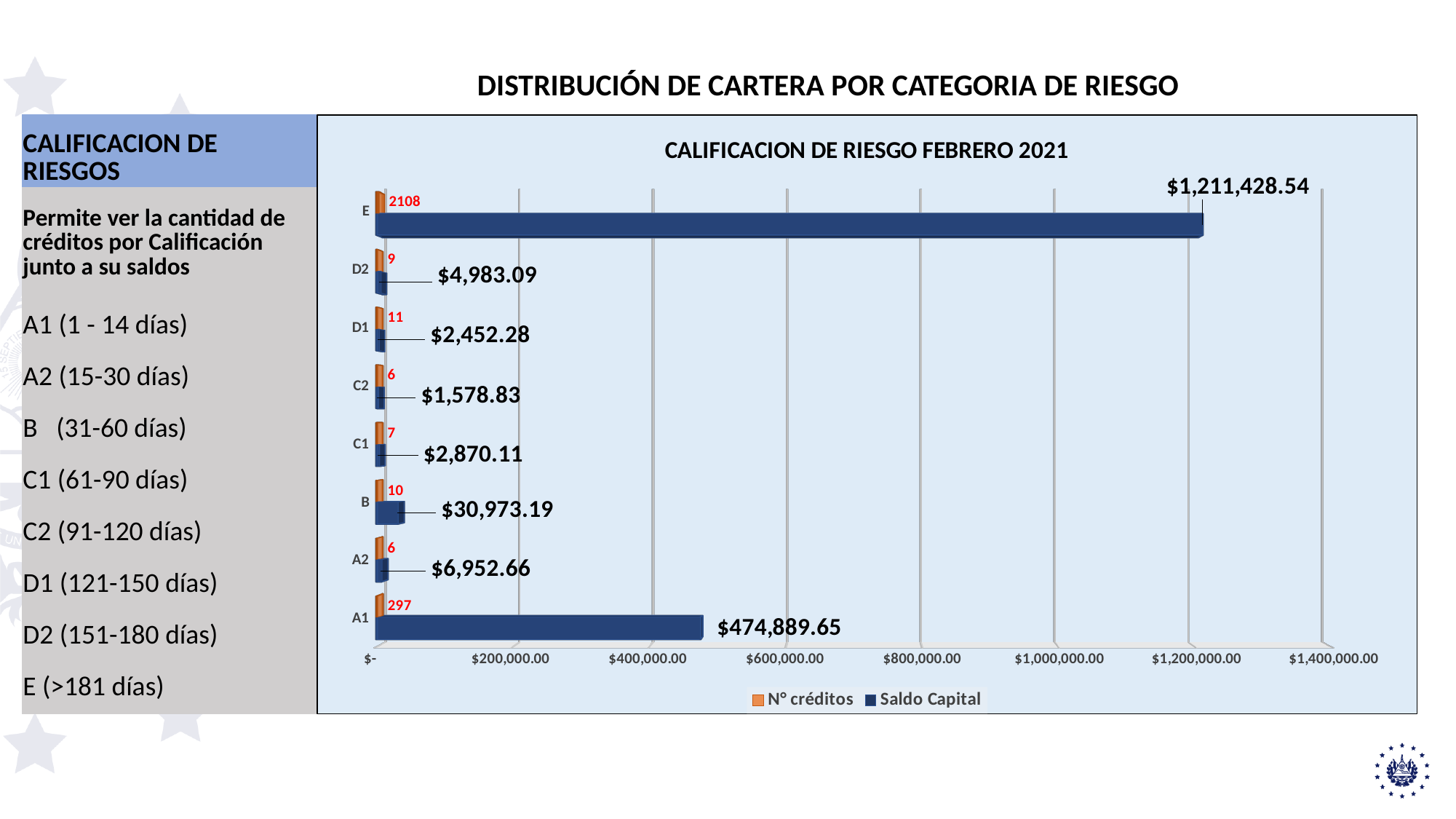
Which category has the highest Saldo Capital? E What is the difference in Saldo Capital between category E and category A1? $736,538.89 What is the Saldo Capital value for category B? $30,973.19 What is the Saldo Capital value for category E? $1,211,428.54 Is the Saldo Capital value for category A1 greater or less than $400,000.00? greater What kind of chart is shown on the slide? Bar chart What is the N° créditos value for category D1? 11 What is the N° créditos value for category A1? 297 How many series does the legend list? 2 Which has a larger Saldo Capital, category D2 or category A2? A2 Which category has the lowest Saldo Capital? C2 How many categories are shown on the chart? 8